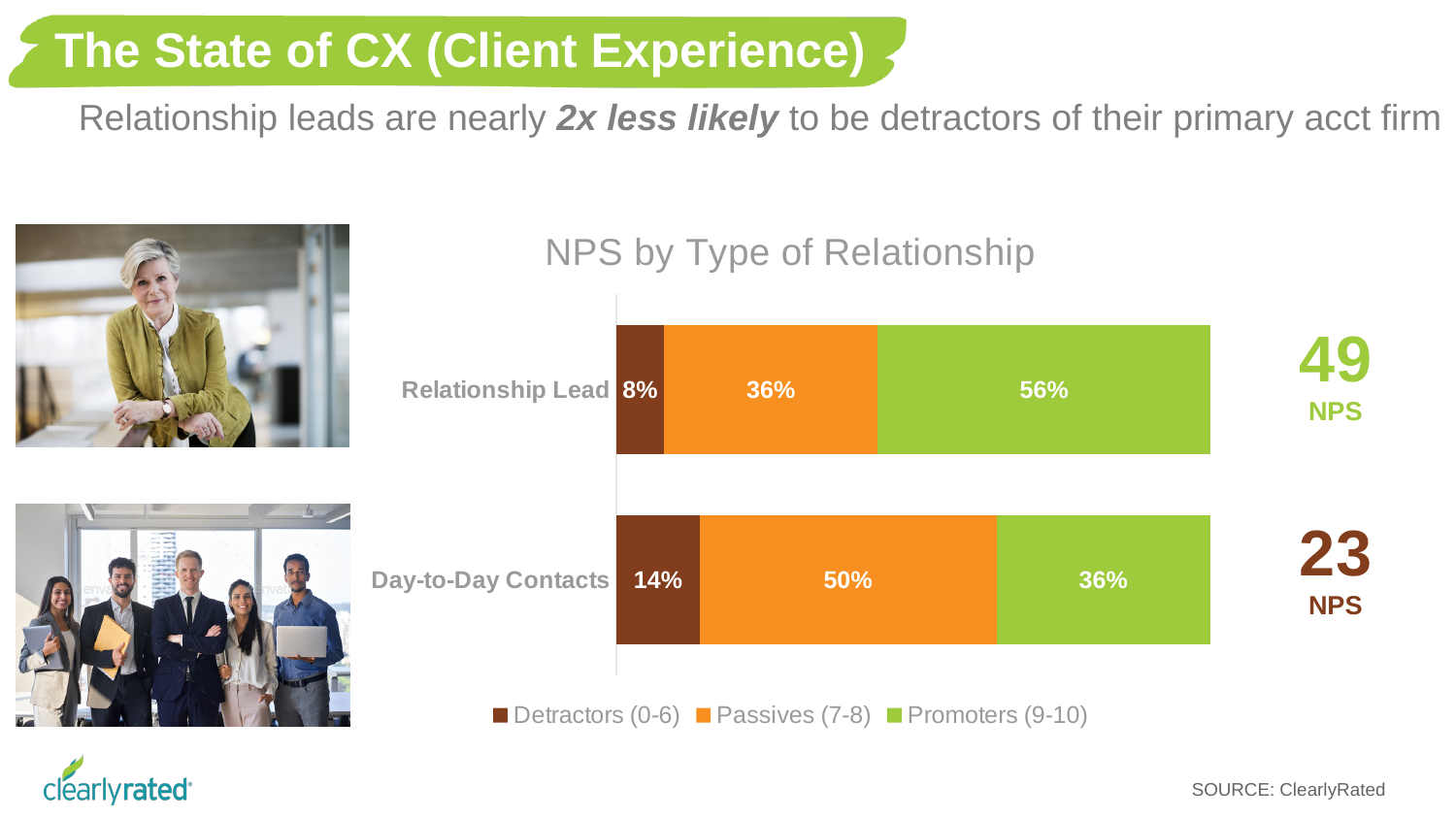
What is the title of the chart? NPS by Type of Relationship What percentage of Day-to-Day Contacts are Detractors (0-6)? 14% What percentage of Relationship Leads are Detractors (0-6)? 8% Which relationship type has the lower share of Detractors (0-6)? Relationship Lead Which relationship type has the higher share of Promoters (9-10)? Relationship Lead How many relationship types are shown in the chart? 2 How many series does the legend list? 3 What is the difference in the Promoters (9-10) share between Relationship Lead and Day-to-Day Contacts? 20% What is the difference in the Detractors (0-6) share between Day-to-Day Contacts and Relationship Lead? 6% What percentage of Day-to-Day Contacts are Passives (7-8)? 50% What percentage of Relationship Leads are Promoters (9-10)? 56% What kind of chart is shown on the slide? Stacked bar chart